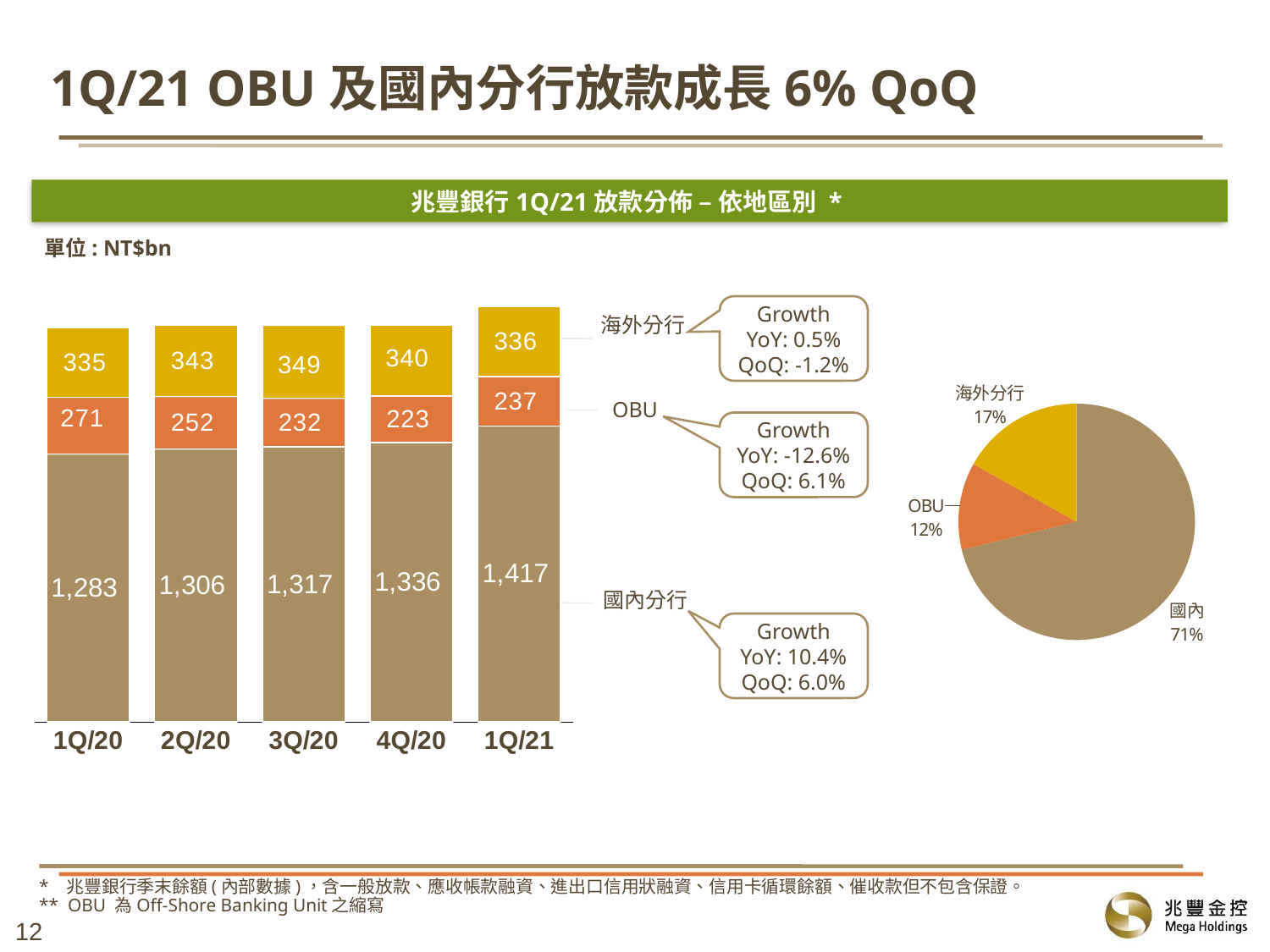
In the stacked bar chart, is the OBU value for 1Q/20 larger or smaller than the OBU value for 1Q/21? larger In the stacked bar chart, what is the value for 國內分行 in 1Q/21? 1,417 In the stacked bar chart, does the 國內分行 value rise or fall from 1Q/20 to 1Q/21? rise How many quarters are shown on the x axis of the stacked bar chart? 5 In the stacked bar chart, which quarter has the highest 國內分行 value? 1Q/21 In the stacked bar chart, what is the OBU value for 2Q/20? 252 In the stacked bar chart, which quarter has the lowest OBU value? 4Q/20 In the stacked bar chart, what is the total of the 1Q/21 bar? 1,990 In the pie chart, what share does 國內 have? 71% In the stacked bar chart, what is the 海外分行 value for 3Q/20? 349 What type of chart is shown on the right side of the slide? pie chart In the stacked bar chart, what is the difference between the 國內分行 values for 1Q/21 and 4Q/20? 81